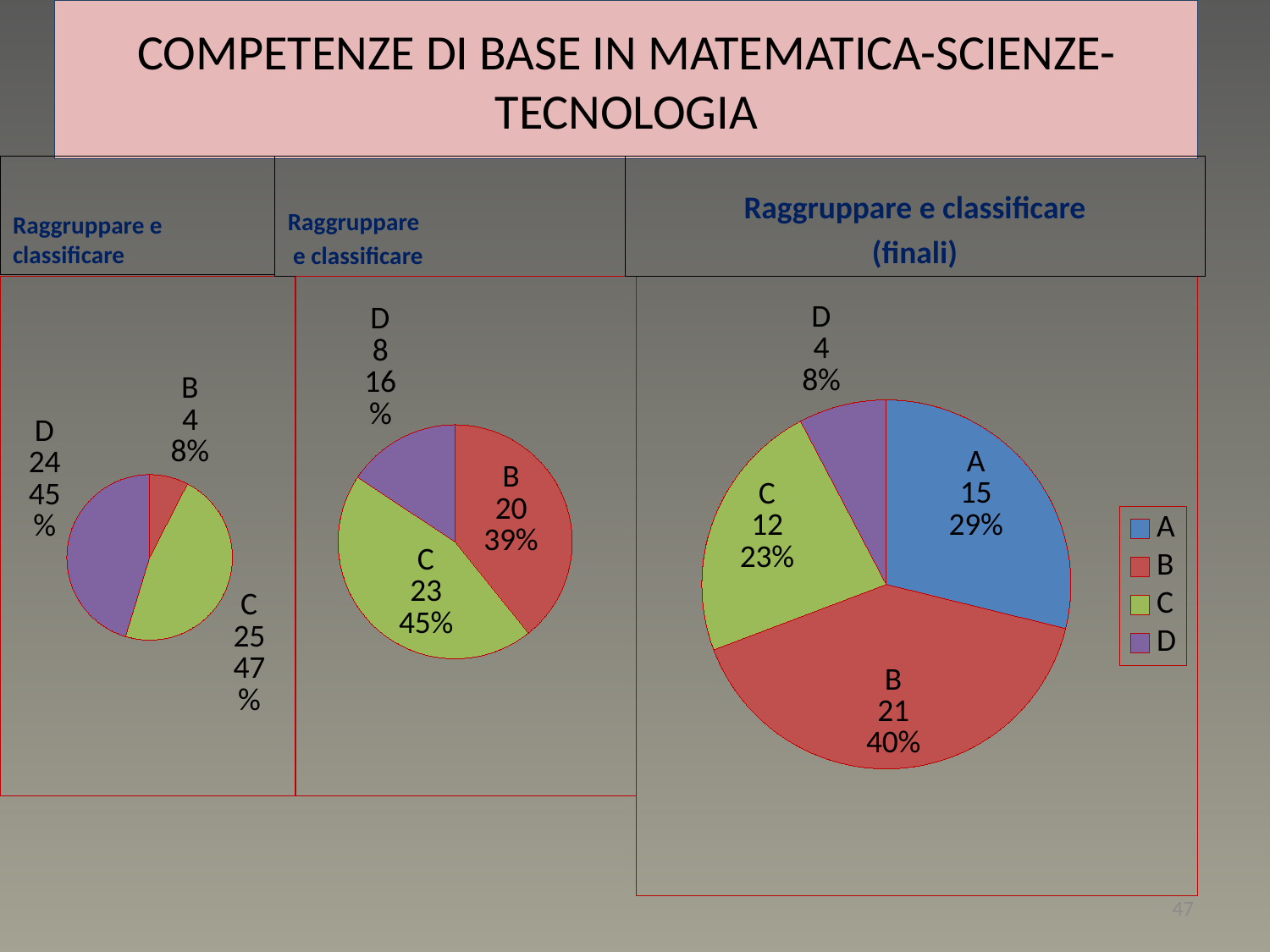
In the right-hand pie chart 'Raggruppare e classificare (finali)', what percentage share does category A have? 29% In the left-most pie chart, which category has the smallest slice? B In the left-most pie chart, what percentage share does category D have? 45% In the right-hand pie chart titled 'Raggruppare e classificare (finali)', what value is shown for category B? 21 In the left-most pie chart, what value is shown for category C? 25 In the right-hand pie chart 'Raggruppare e classificare (finali)', what is the difference between the values for B and C? 9 In the middle pie chart, what value is shown for category C? 23 How many entries does the legend of the right-hand pie chart 'Raggruppare e classificare (finali)' list? 4 What type of chart is used in the right-hand panel 'Raggruppare e classificare (finali)'? Pie chart In the middle pie chart, which is larger, the value for B or the value for D? B In the right-hand pie chart 'Raggruppare e classificare (finali)', which category has the smallest slice? D In the right-hand pie chart 'Raggruppare e classificare (finali)', which category has the largest slice? B